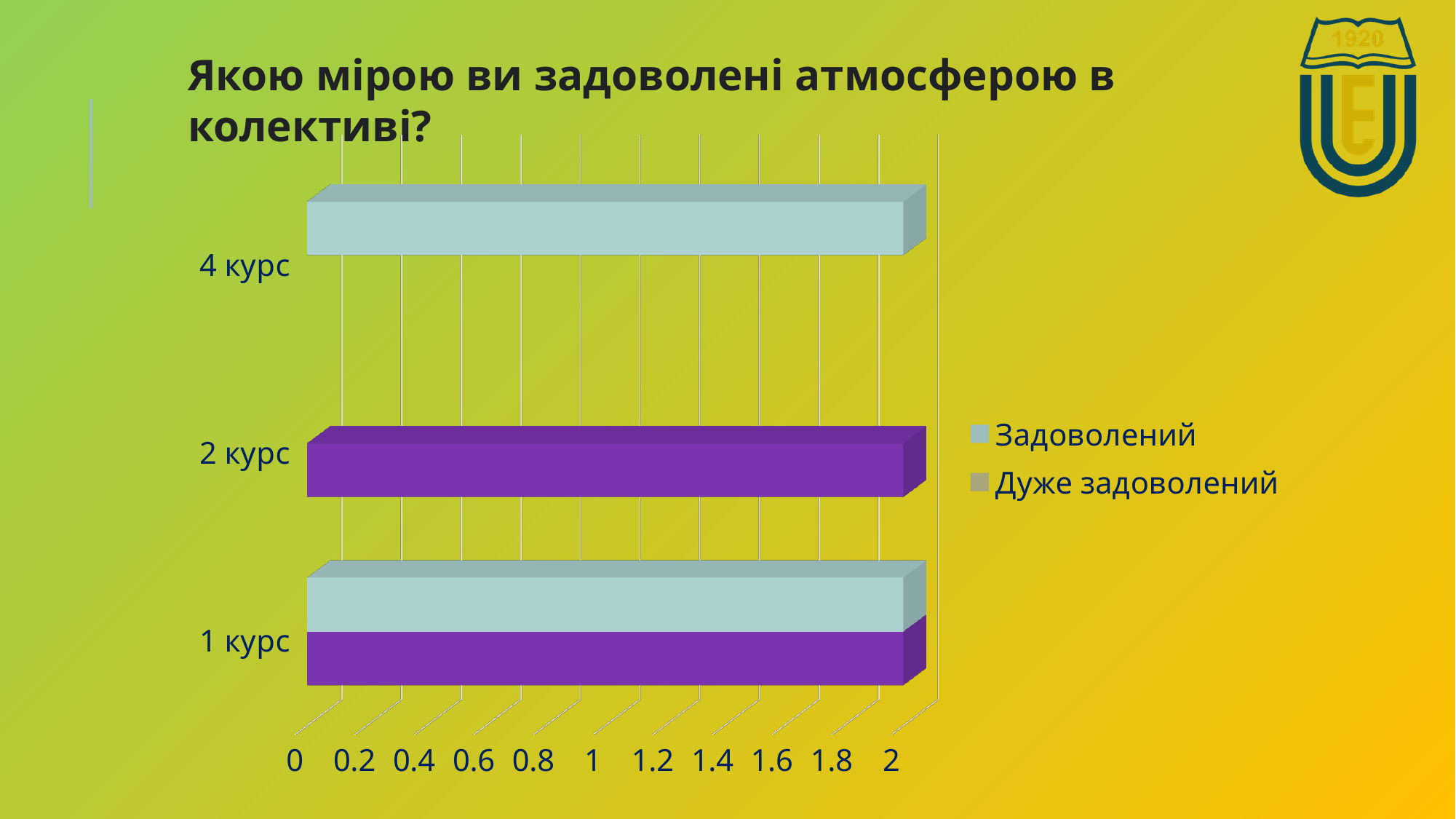
Is the value for Дуже задоволений for 1 курс greater or less than 1? greater Is the value for Задоволений for 1 курс greater or less than 0.8? greater How many series does the legend list? 2 Is the value for Дуже задоволений for 2 курс greater or less than 1.5? greater Which category has a bar only for the Задоволений series? 4 курс What kind of chart is shown on the slide? bar chart What is the highest value shown on the horizontal axis? 2 How many categories are shown on the vertical axis of the chart? 3 Which category has bars for both series? 1 курс